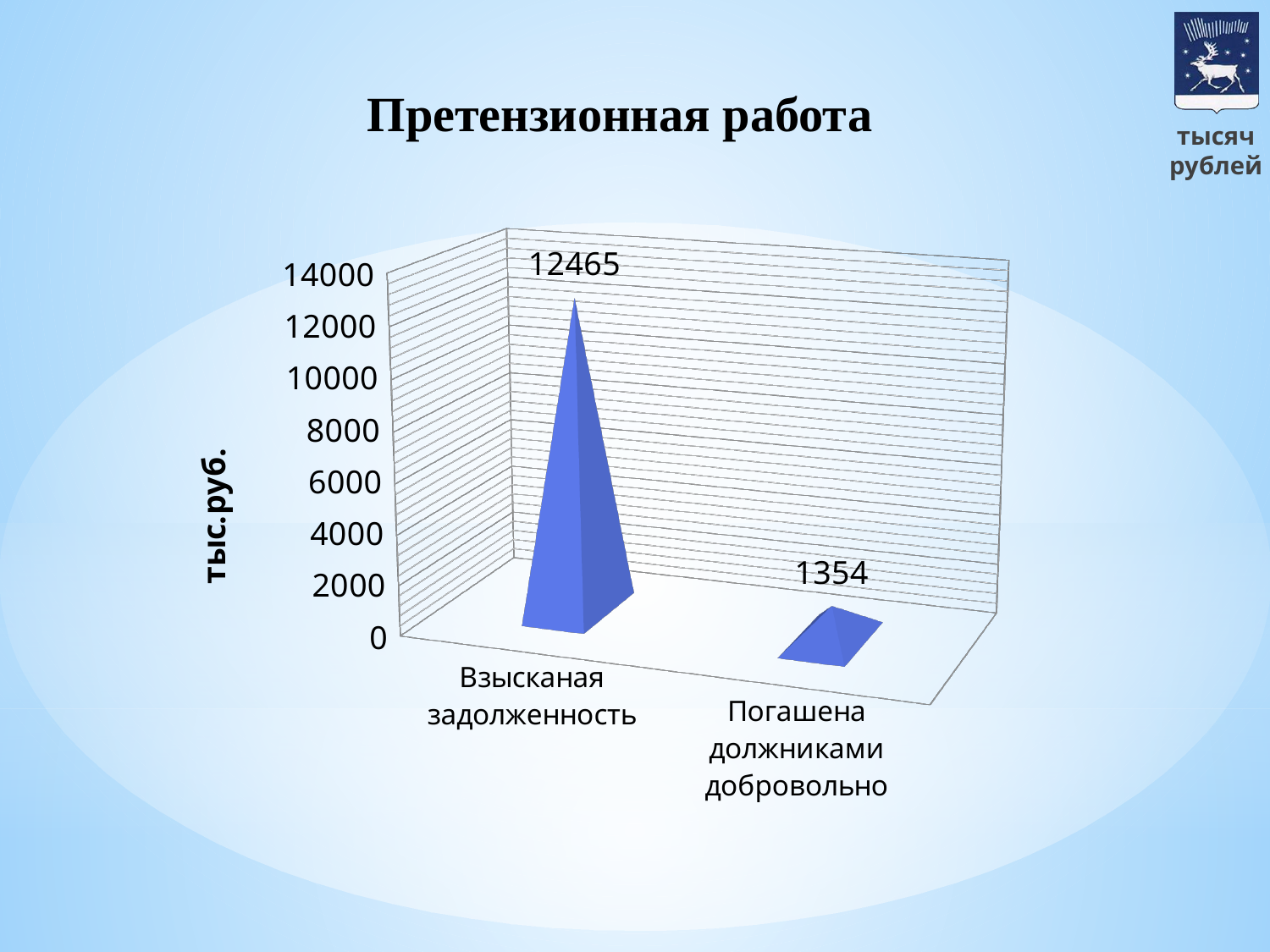
What is the difference between the values for Взысканая задолженность and Погашена должниками добровольно? 11111 Which category has the highest value? Взысканая задолженность Which is larger: the value for Взысканая задолженность or the value for Погашена должниками добровольно? Взысканая задолженность Is the value for Погашена должниками добровольно greater or less than 2000? less What is the title of the chart? Претензионная работа Which category has the lowest value? Погашена должниками добровольно How many categories are shown on the chart? 2 Is the value for Взысканая задолженность greater or less than 10000? greater What is the label of the vertical axis? тыс.руб. What kind of chart is shown on the slide? bar chart What is the value for Погашена должниками добровольно? 1354 What is the value for Взысканая задолженность? 12465